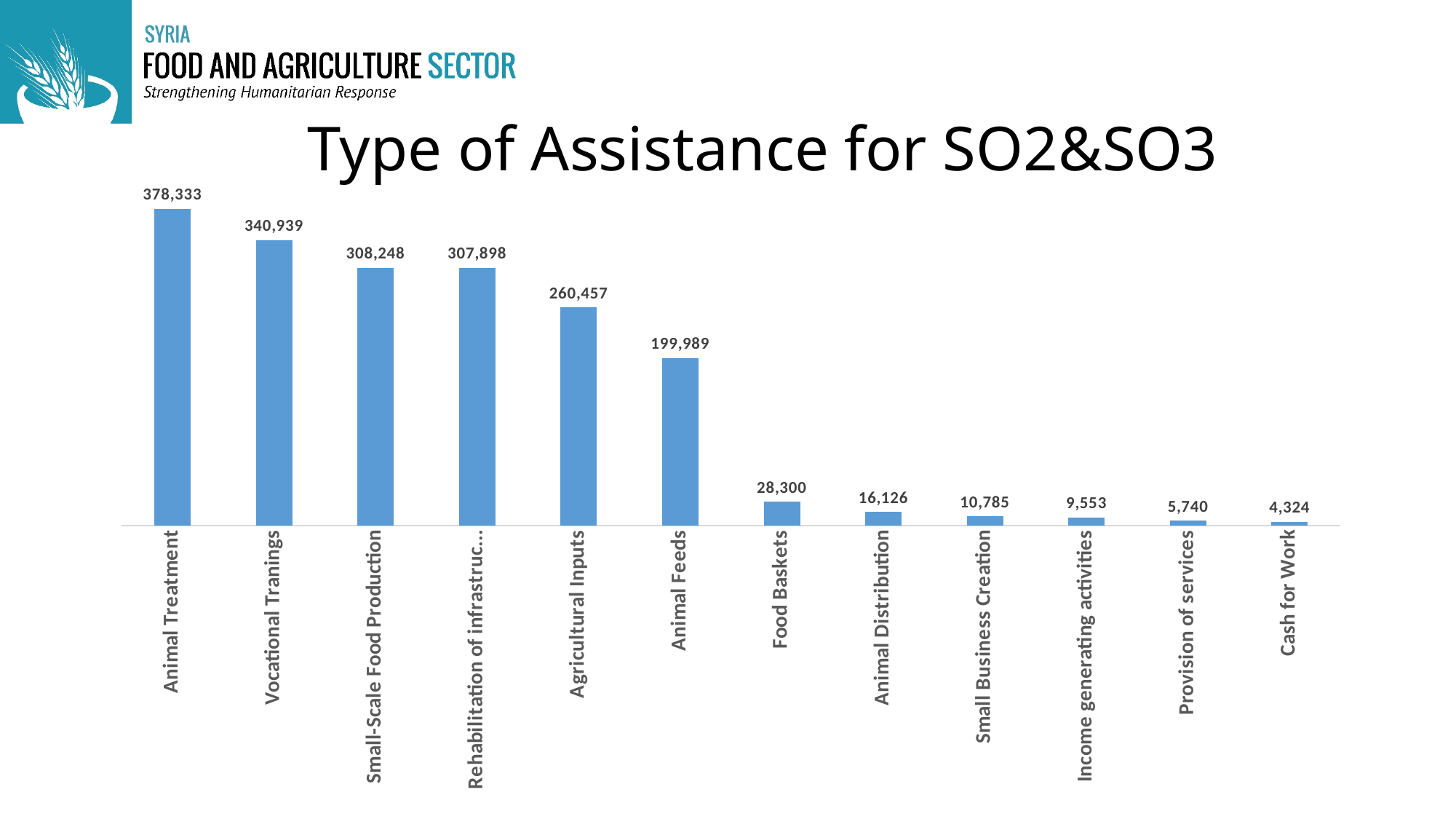
What is the value for Cash for Work? 4,324 What is the value for Food Baskets? 28,300 Which type of assistance has the highest value? Animal Treatment Which type of assistance has the lowest value? Cash for Work What is the value for Agricultural Inputs? 260,457 Which is larger, the value for Animal Feeds or the value for Agricultural Inputs? Agricultural Inputs How many types of assistance are shown in the chart? 12 What kind of chart is shown on the slide? Bar chart Do the values rise or fall from left to right across the chart? Fall What is the value for Animal Treatment? 378,333 What is the difference between the values for Animal Treatment and Vocational Tranings? 37,394 What is the difference between the values for Food Baskets and Animal Distribution? 12,174